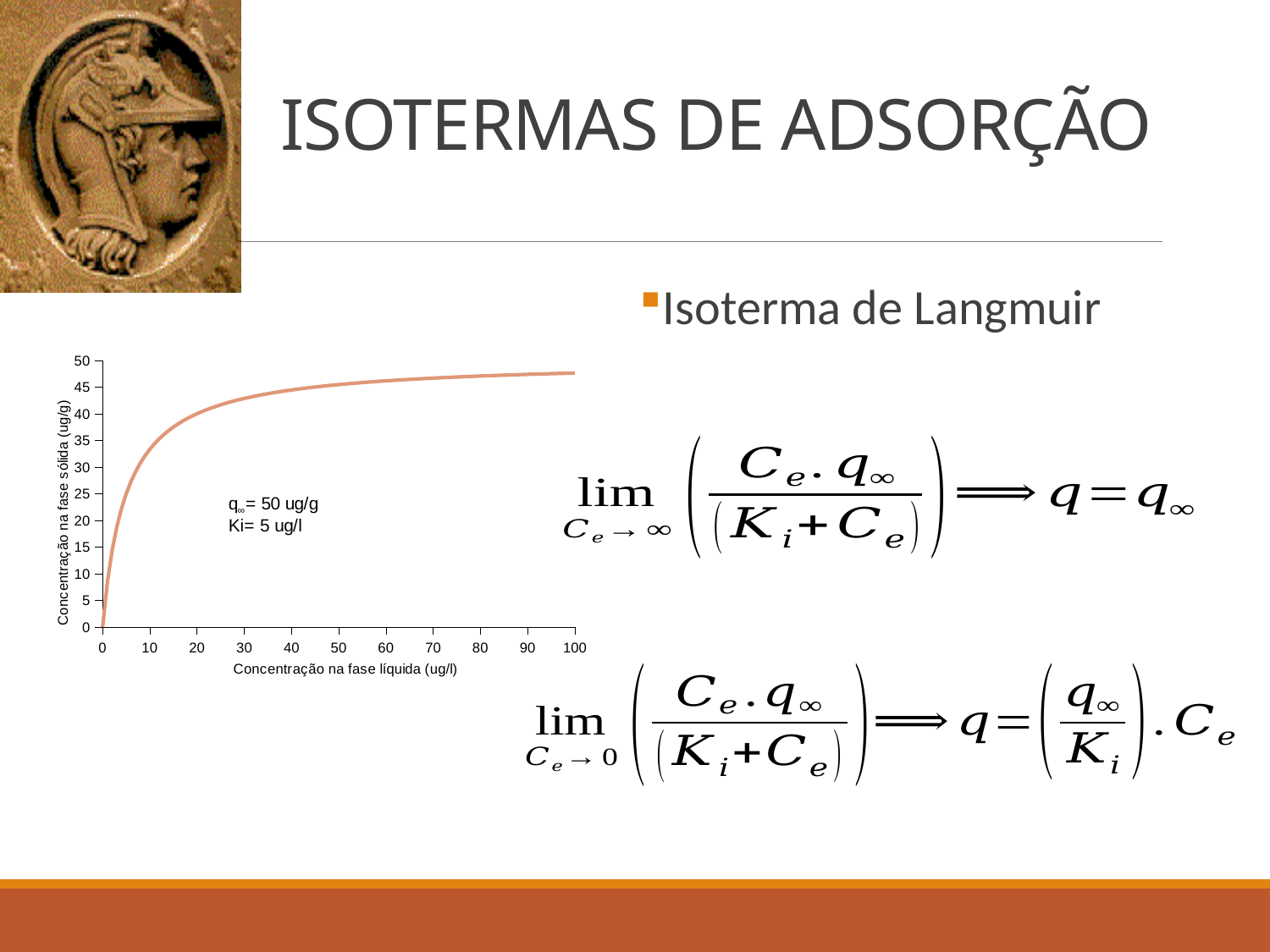
What is the value of q∞ given in the annotation on the chart? 50 ug/g What kind of chart is shown on the slide? line chart What is the title of the y axis of the chart? Concentração na fase sólida (ug/g) What is the highest value shown on the x axis of the chart? 100 Do the values on the chart rise or fall as the concentration in the liquid phase increases? rise Is the value of the curve at a liquid-phase concentration of 10 ug/l greater or less than 30? greater Is the value of the curve at a liquid-phase concentration of 100 ug/l greater or less than 50? less What is the value of Ki given in the annotation on the chart? 5 ug/l Is the value of the curve at a liquid-phase concentration of 10 ug/l greater or less than 35? less